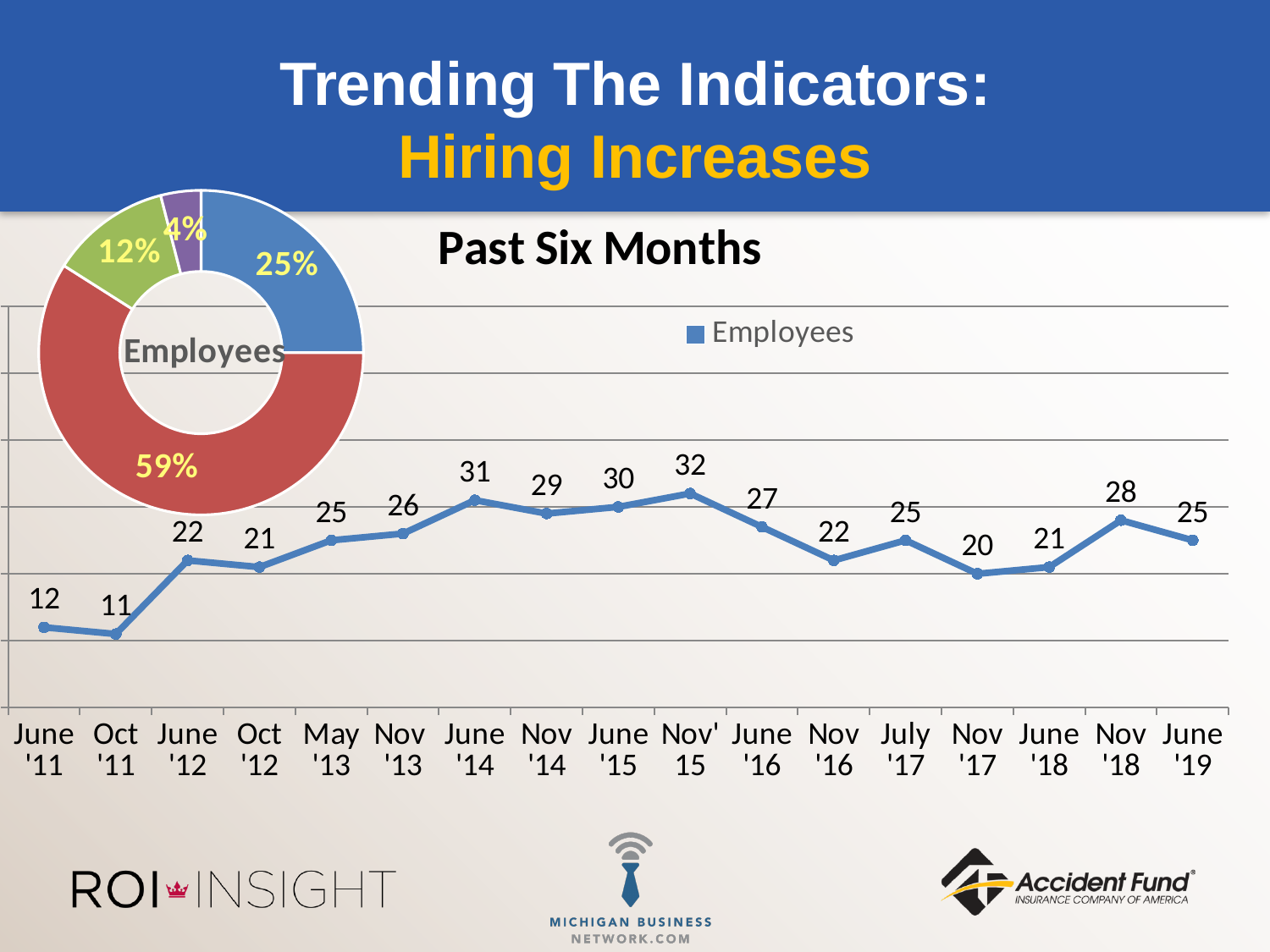
What kind of chart is the 'Past Six Months' chart? Line chart In the 'Past Six Months' line chart, what is the difference between the values for Nov '18 and June '19? 3 In the 'Past Six Months' line chart, which period has the lowest value? Oct '11 How many data points are plotted in the 'Past Six Months' line chart? 17 In the 'Past Six Months' line chart, do the values rise or fall from Nov '17 to Nov '18? Rise In the 'Employees' donut chart, what is the share of the largest slice? 59% In the 'Past Six Months' line chart, what is the value for Nov '18? 28 How many slices does the 'Employees' donut chart have? 4 In the 'Past Six Months' line chart, which period has the highest value? Nov' 15 In the 'Past Six Months' line chart, which is larger, the value for June '14 or the value for Nov '14? June '14 In the 'Past Six Months' line chart, what is the value for June '19? 25